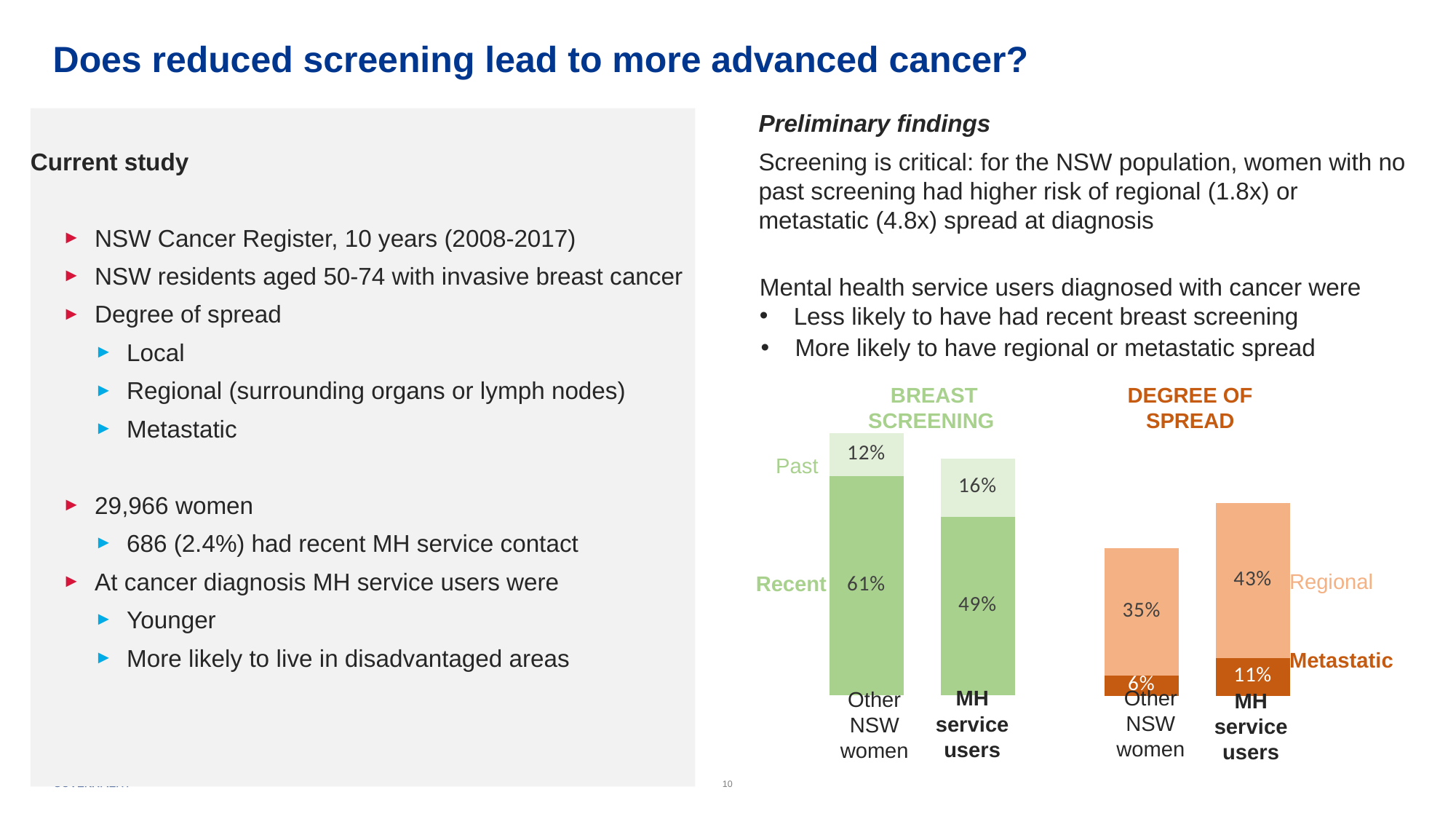
In the BREAST SCREENING chart, what is the Past screening value for MH service users? 16% In the BREAST SCREENING chart, what is the Recent screening value for Other NSW women? 61% In the DEGREE OF SPREAD chart, what is the Metastatic value for MH service users? 11% In the BREAST SCREENING chart, what is the total of the stacked bar for Other NSW women? 73% In the BREAST SCREENING chart, what is the difference between the Recent screening values for Other NSW women and MH service users? 12% In the DEGREE OF SPREAD chart, what is the total of the stacked bar for MH service users? 54% How many groups (bars) are shown in the BREAST SCREENING chart? 2 In the DEGREE OF SPREAD chart, what is the difference between the Metastatic values for MH service users and Other NSW women? 5% What type of chart is the DEGREE OF SPREAD chart? Stacked bar chart In the DEGREE OF SPREAD chart, which group has the higher Regional value? MH service users In the DEGREE OF SPREAD chart, what is the Regional value for Other NSW women? 35% In the BREAST SCREENING chart, which group has the higher Recent screening value? Other NSW women